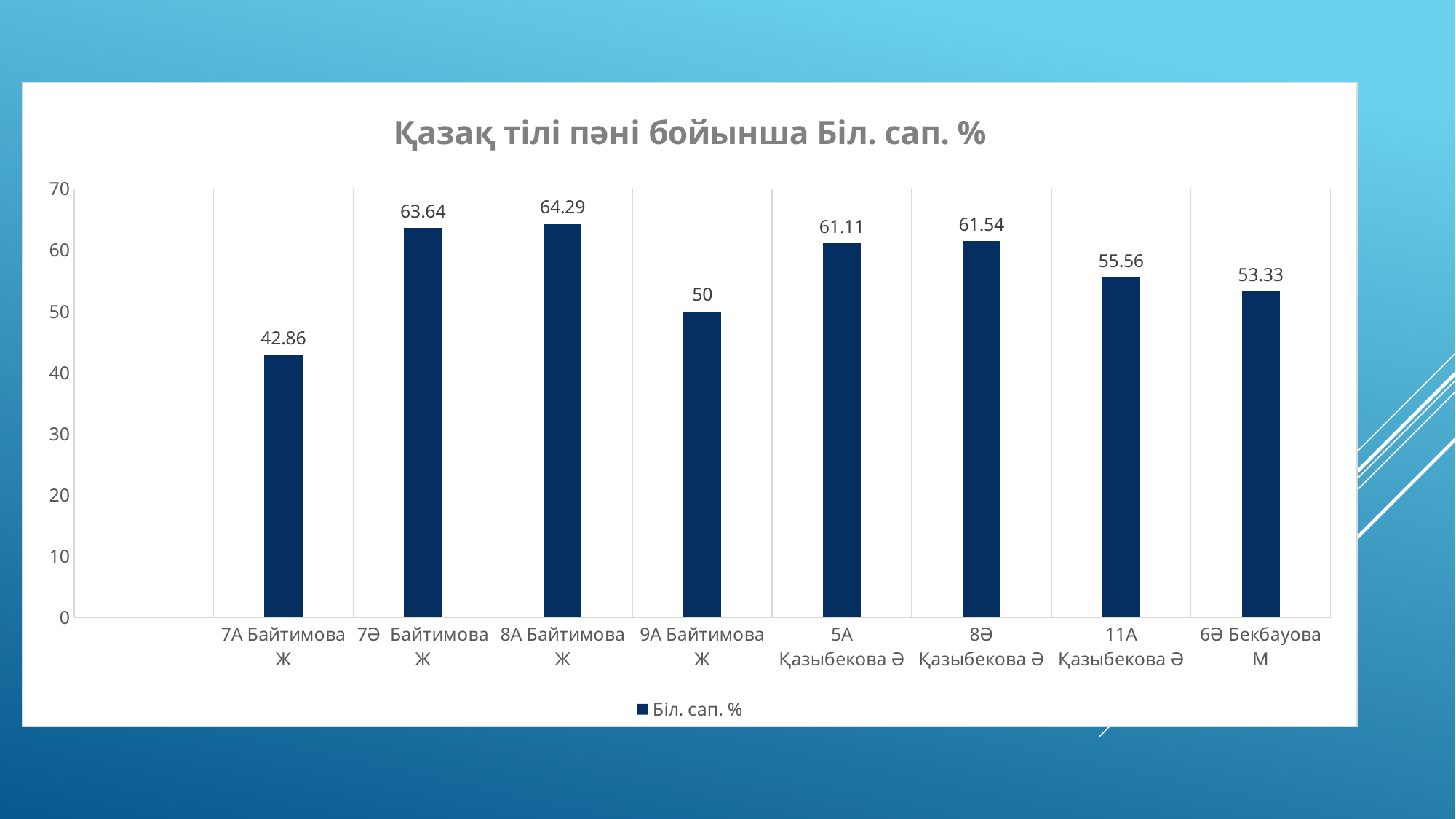
Is the value for 5А Қазыбекова Ә greater or less than 60? greater Which category has the highest value? 8А Байтимова Ж What is the title of the chart? Қазақ тілі пәні бойынша Біл. сап. % What is the value for 6Ә Бекбауова М? 53.33 What is the value for 7А Байтимова Ж? 42.86 What kind of chart is shown on the slide? bar chart How many categories are shown on the x axis? 8 What is the value for 11А Қазыбекова Ә? 55.56 What is the difference between the values for 7Ә Байтимова Ж and 7А Байтимова Ж? 20.78 Which is larger, the value for 11А Қазыбекова Ә or the value for 6Ә Бекбауова М? 11А Қазыбекова Ә Which category has the lowest value? 7А Байтимова Ж What is the value for 9А Байтимова Ж? 50